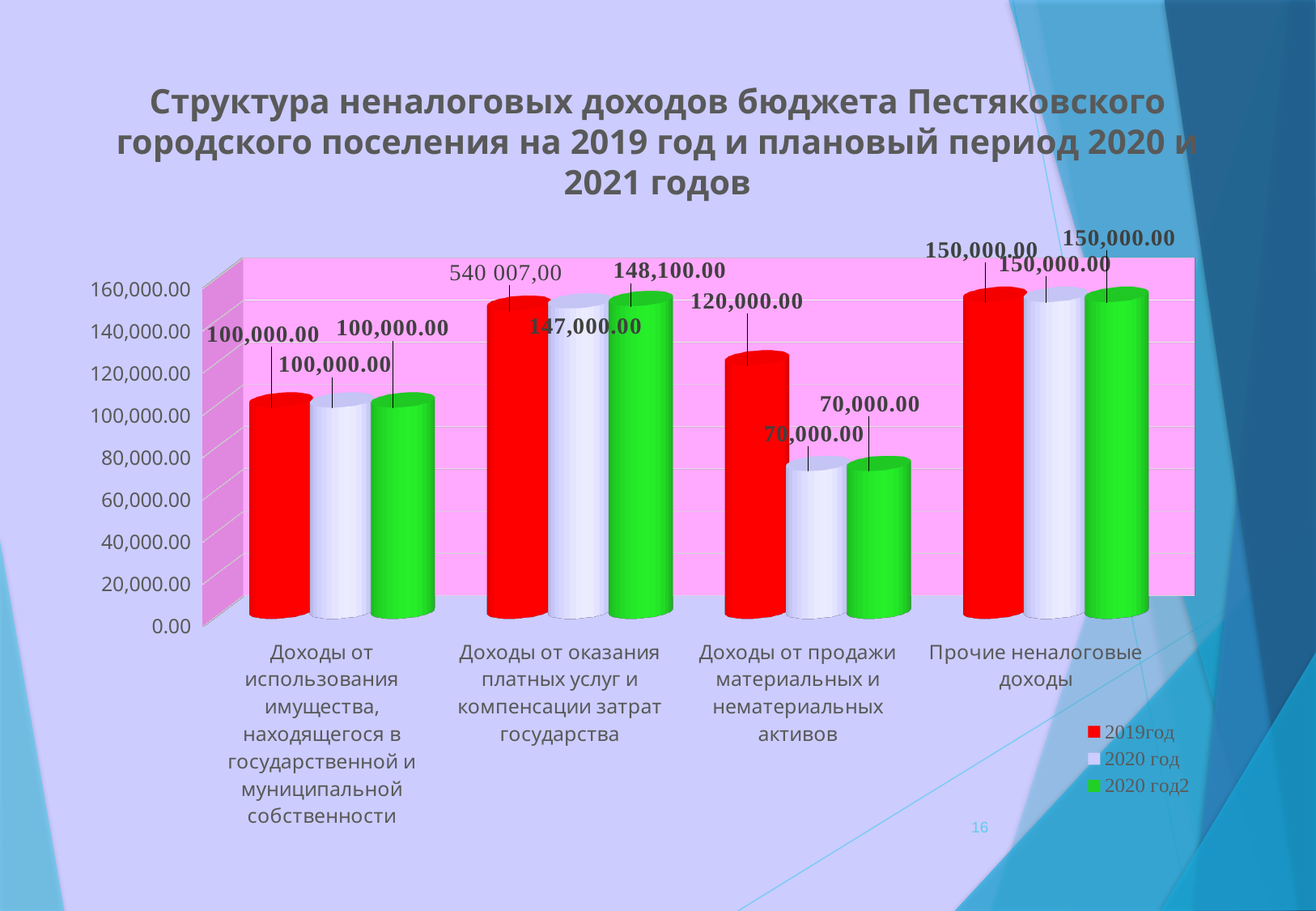
For the 2020 год2 series, which is larger: 'Доходы от оказания платных услуг и компенсации затрат государства' or 'Прочие неналоговые доходы'? Прочие неналоговые доходы What is the value for 2020 год in the category 'Доходы от оказания платных услуг и компенсации затрат государства'? 147,000.00 What kind of chart is shown on the slide? bar chart What is the value for 2020 год2 in the category 'Доходы от оказания платных услуг и компенсации затрат государства'? 148,100.00 For the 2019год series, which category has the lowest value? Доходы от использования имущества, находящегося в государственной и муниципальной собственности What is the difference between the 2019год and 2020 год values in the category 'Доходы от продажи материальных и нематериальных активов'? 50,000.00 What is the value for 2019год in the category 'Доходы от продажи материальных и нематериальных активов'? 120,000.00 What colour represents the 2019год series? red How many categories are shown on the x axis? 4 How many series does the legend list? 3 What is the value for 2019год in the category 'Прочие неналоговые доходы'? 150,000.00 What is the value for 2020 год in the category 'Доходы от продажи материальных и нематериальных активов'? 70,000.00